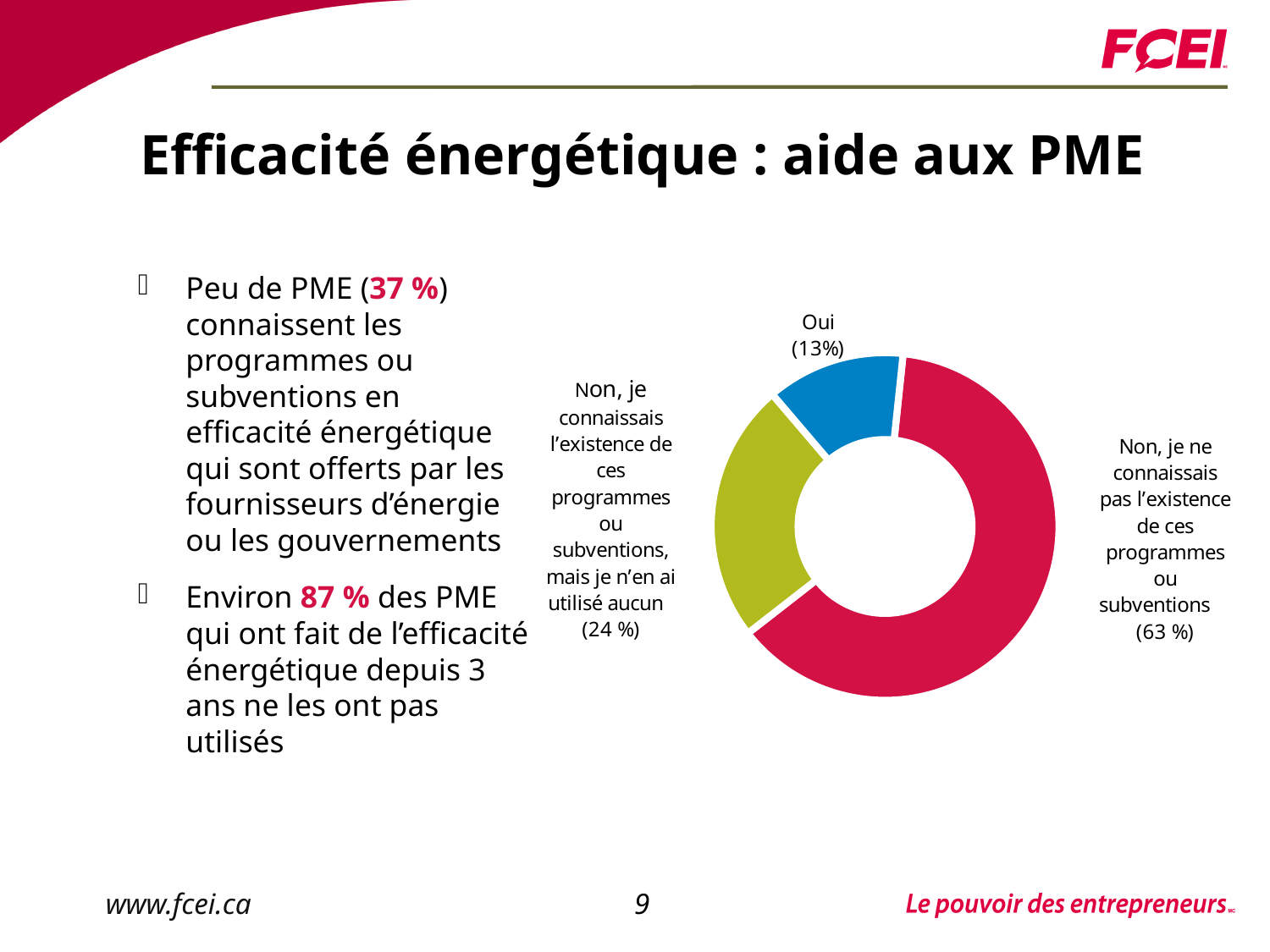
Which slice of the doughnut chart is the largest? Non, je ne connaissais pas l'existence de ces programmes ou subventions (63 %) What is the difference in percentage points between the "Non, je ne connaissais pas" slice and the "Oui" slice? 50 percentage points What share of the doughnut chart is labelled "Oui"? 13% What share of the doughnut chart is labelled "Non, je connaissais l'existence de ces programmes ou subventions, mais je n'en ai utilisé aucun"? 24 % What is the combined share of the two "Non" slices in the doughnut chart? 87 % What kind of chart is shown on the slide? Doughnut chart Which is larger: the "Oui" slice or the "Non, je connaissais l'existence... mais je n'en ai utilisé aucun" slice? Non, je connaissais l'existence... mais je n'en ai utilisé aucun (24 %) What colour is the "Oui" slice in the doughnut chart? Blue How many slices does the doughnut chart have? 3 Which slice of the doughnut chart is the smallest? Oui (13%) What colour is the largest slice of the doughnut chart? Red What share of the doughnut chart is labelled "Non, je ne connaissais pas l'existence de ces programmes ou subventions"? 63 %